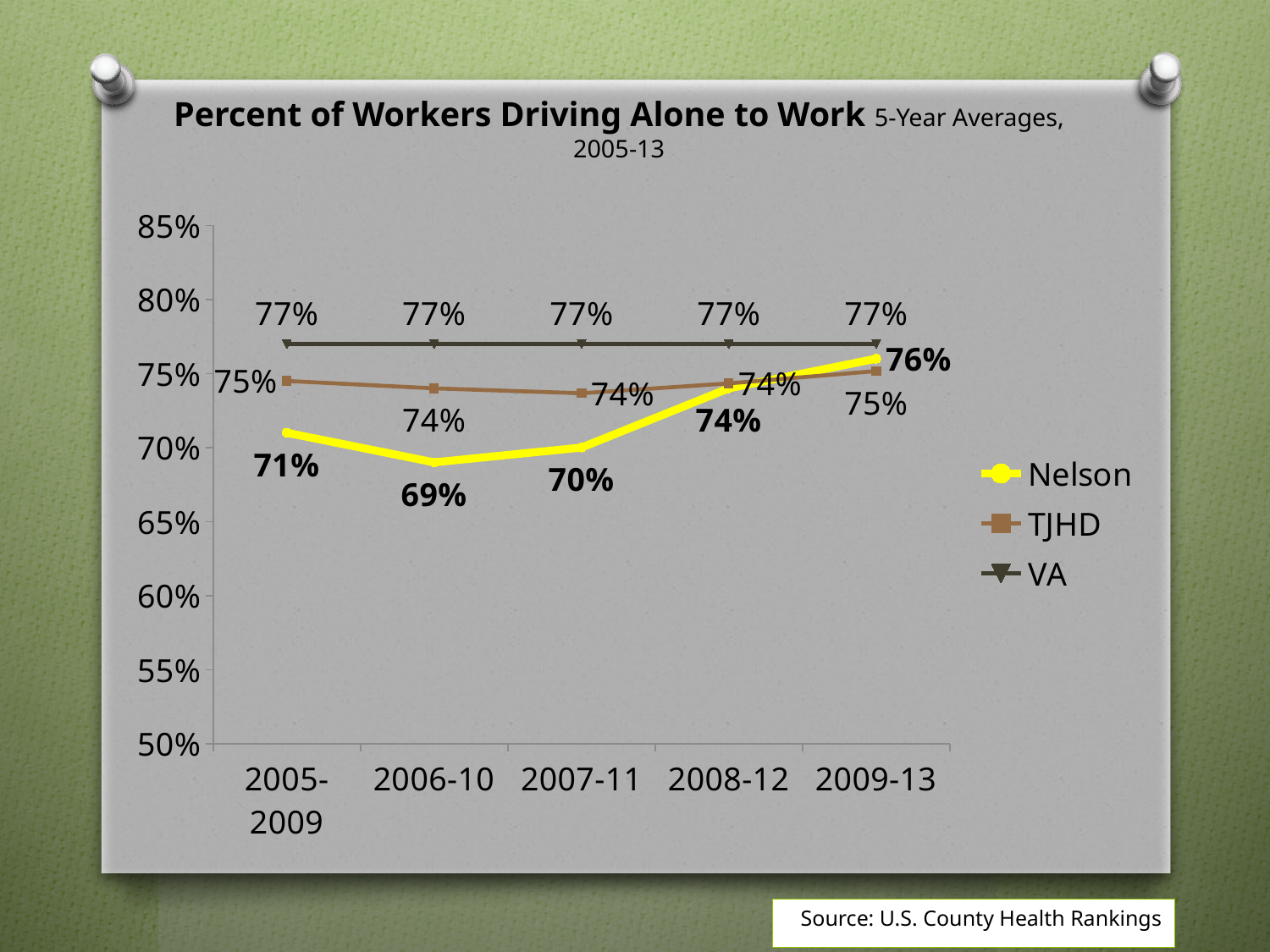
Which is larger in 2009-13, the Nelson value or the TJHD value? Nelson What kind of chart is shown on the slide? line chart What is the difference between the VA value and the Nelson value in 2006-10? 8% What is the value for Nelson in 2009-13? 76% How many series does the legend list? 3 What is the value for VA in 2008-12? 77% Which series is drawn in yellow? Nelson How many time periods are shown on the x axis? 5 Does the Nelson series rise or fall from 2007-11 to 2009-13? rise What is the value for TJHD in 2005-2009? 75% In which period is the Nelson value lowest? 2006-10 What is the value for Nelson in 2006-10? 69%